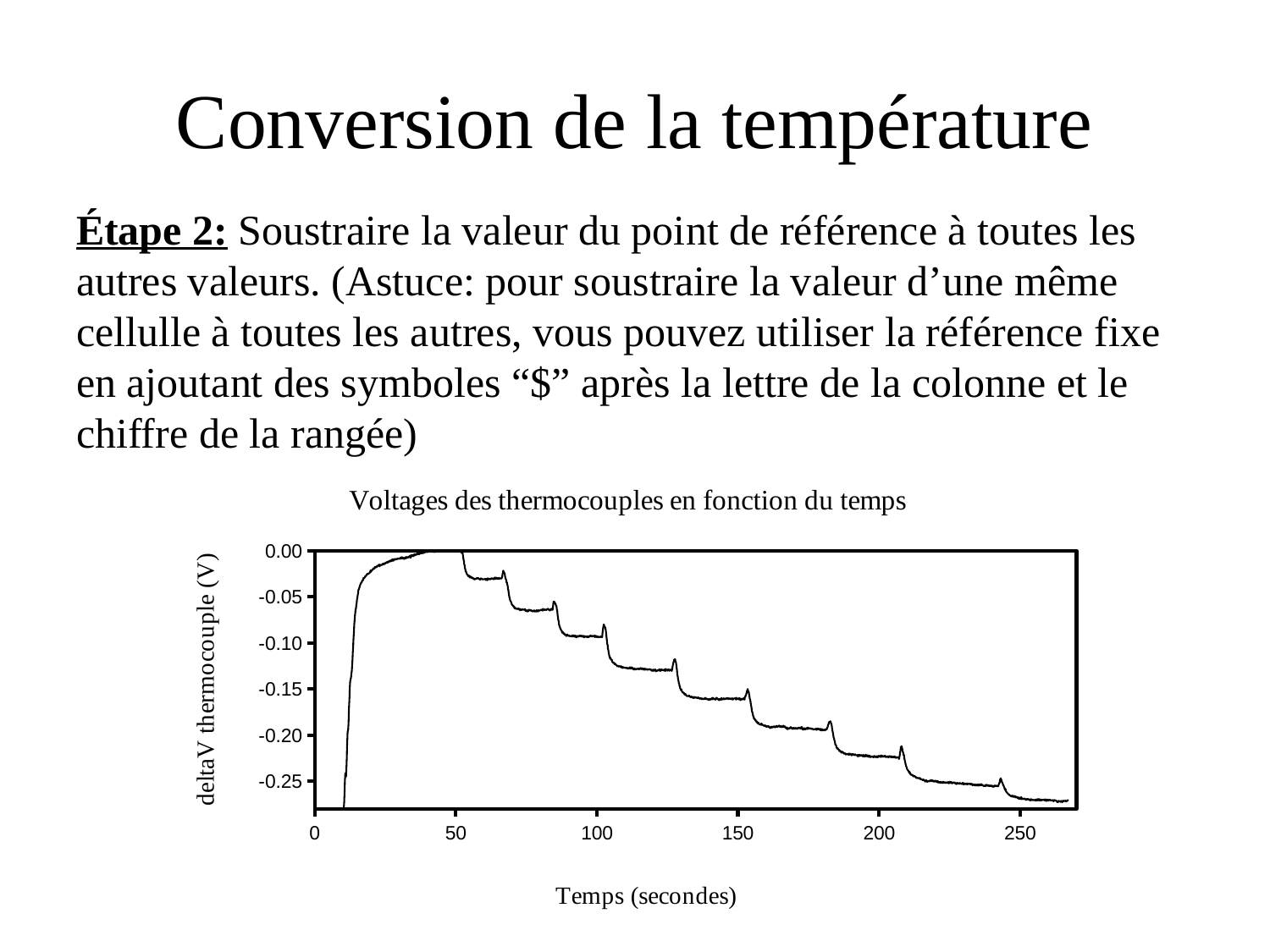
What is the label of the x axis of the chart? Temps (secondes) Is the value of deltaV thermocouple at 100 seconds greater or less than -0.05? less Is the value of deltaV thermocouple at 250 seconds greater or less than -0.25? less Do the plotted voltage values rise or fall along the x axis after 50 seconds? fall Is the value of deltaV thermocouple at 150 seconds greater or less than -0.10? less What is the title of the chart? Voltages des thermocouples en fonction du temps What kind of chart is shown on the slide? line chart Which is larger, the deltaV thermocouple value at 100 seconds or at 200 seconds? 100 seconds